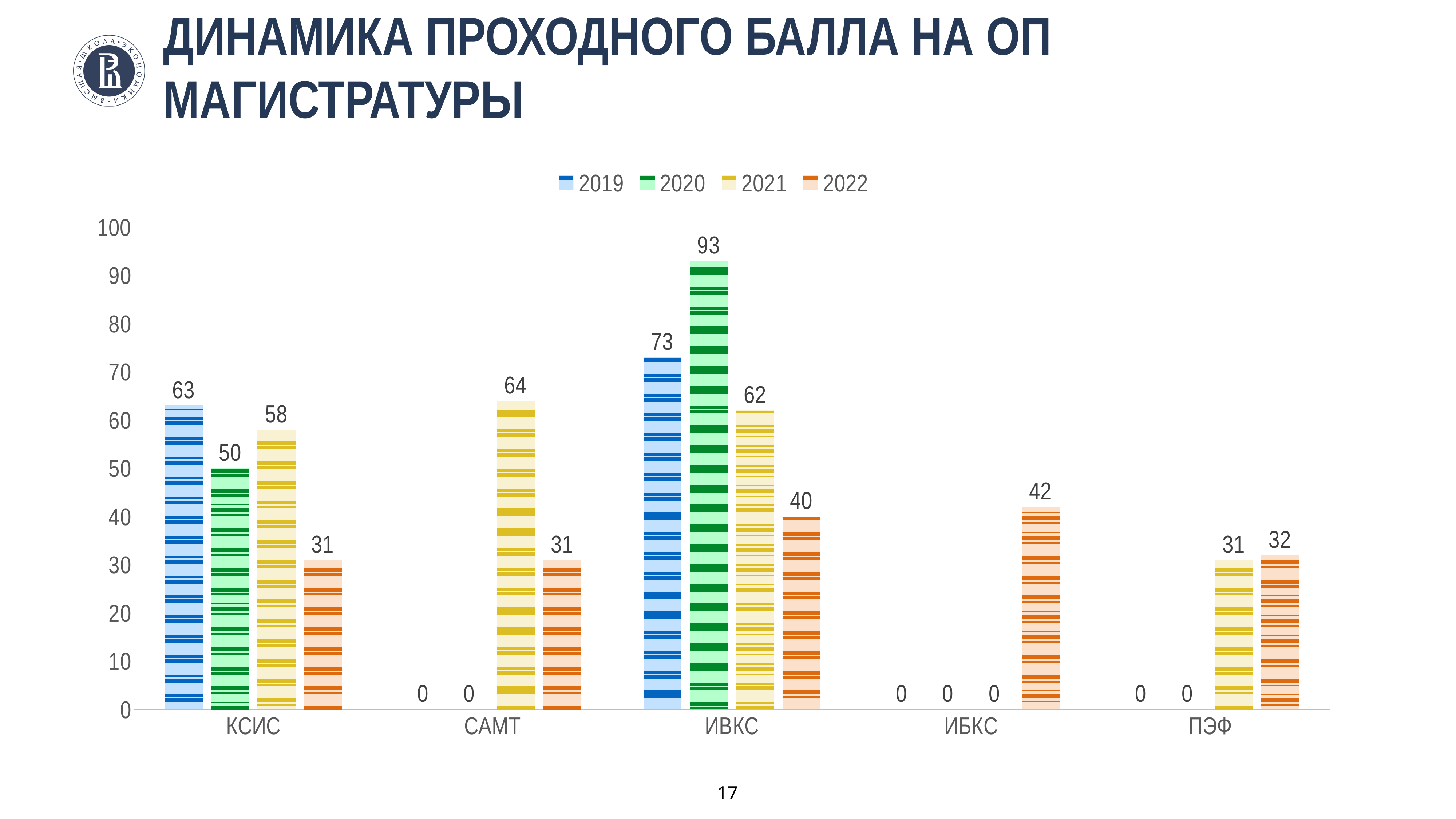
What is the difference between the 2020 and 2019 values for ИВКС? 20 Do the values for ИВКС rise or fall from 2020 to 2022? fall What is the value for КСИС in 2019? 63 What is the value for САМТ in 2021? 64 How many series does the legend list? 4 Which category has the lowest value in the 2022 series? КСИС and САМТ (both 31) What is the value for ИБКС in 2022? 42 Which category has the highest value in the 2020 series? ИВКС What is the value for ИВКС in 2020? 93 What type of chart is shown on the slide? bar chart Which is larger for КСИС: the 2021 value or the 2020 value? 2021 How many categories are shown on the x axis? 5